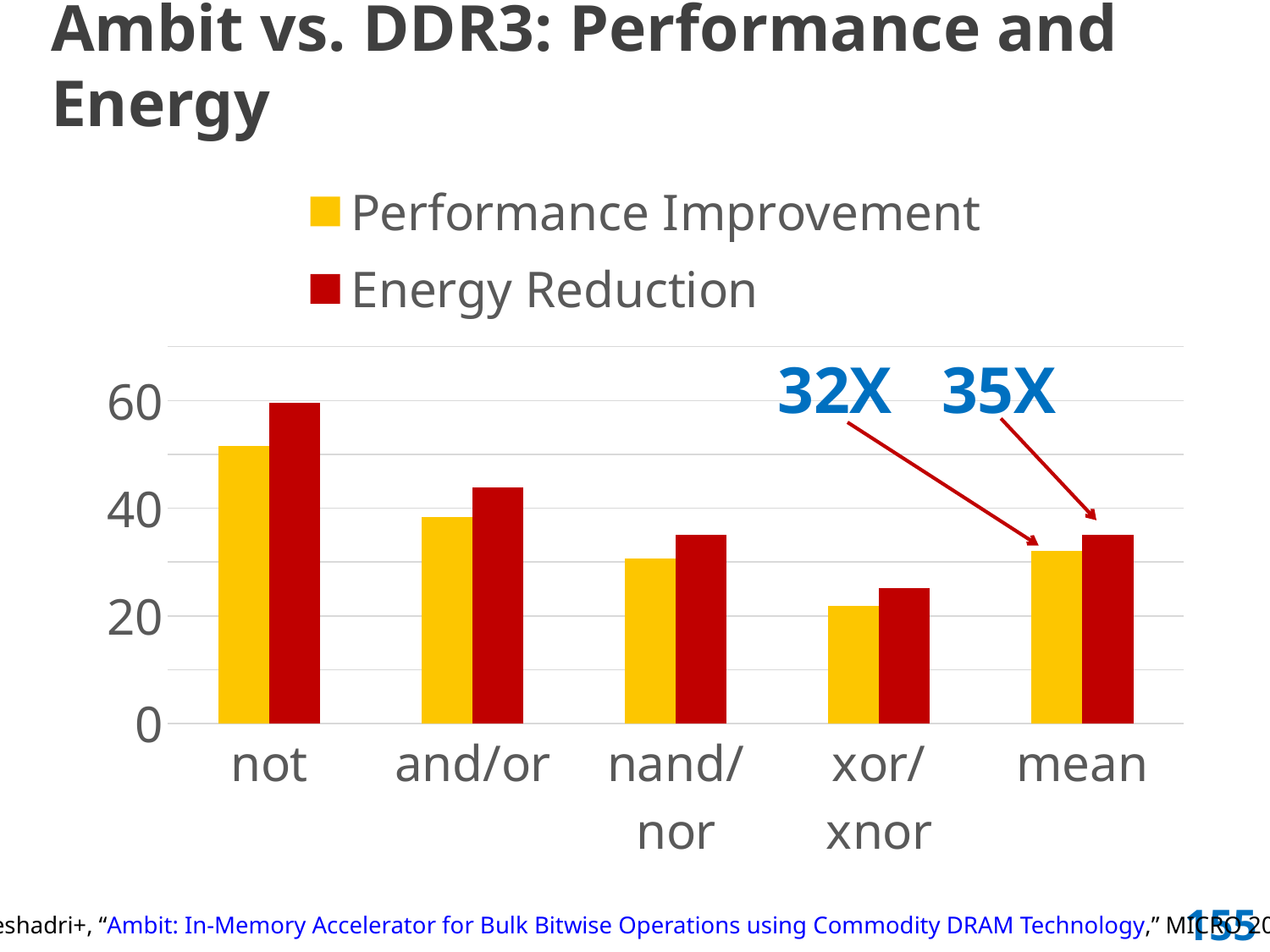
How many series does the legend list? 2 What is the Energy Reduction value annotated for the mean category? 35X For the not category, which is larger: Performance Improvement or Energy Reduction? Energy Reduction Which category has the lowest Energy Reduction? xor/xnor Do the Performance Improvement values rise or fall from not to xor/xnor along the x axis? fall What is the Performance Improvement value annotated for the mean category? 32X What kind of chart is shown on the slide? bar chart Is the Energy Reduction value for not greater or less than 40? greater Which category has the highest Performance Improvement? not Which colour represents Energy Reduction in the legend? red Is the Performance Improvement value for xor/xnor greater or less than 40? less How many categories are shown on the x axis? 5